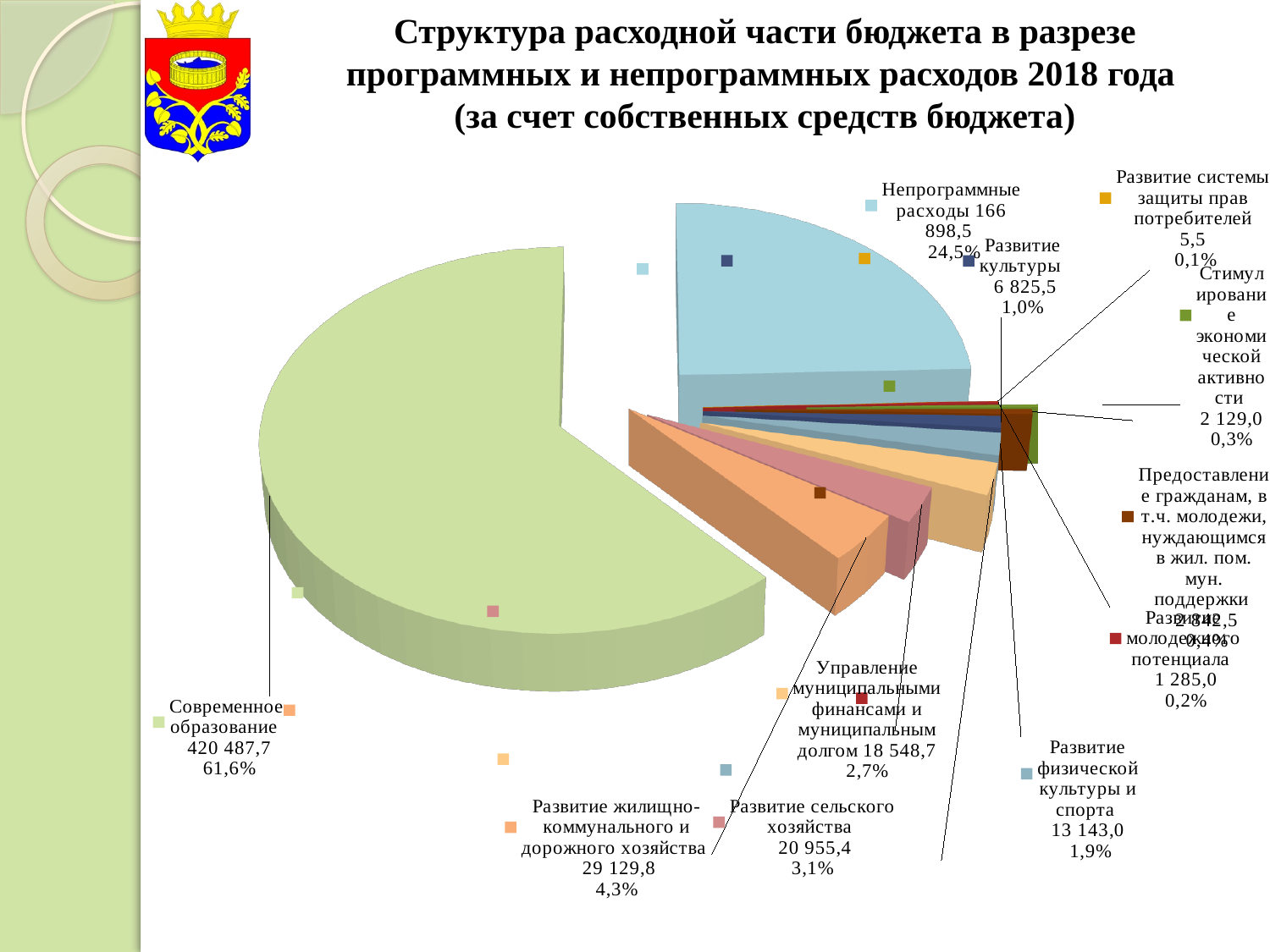
What is the value shown for Непрограммные расходы? 166 898,5 What is the value shown for Современное образование? 420 487,7 What is the value shown for Развитие физической культуры и спорта? 13 143,0 What type of chart is shown on the slide? pie chart Which category has the largest slice of the pie? Современное образование What percentage is shown for Развитие сельского хозяйства? 3,1% Which category has the smallest value in the chart? Развитие системы защиты прав потребителей What is the difference in percentage points between Современное образование (61,6%) and Непрограммные расходы (24,5%)? 37,1 What share of the pie does Современное образование take? 61,6% What year does the chart title refer to? 2018 How many categories are labelled in the pie chart? 11 Which is larger: Развитие жилищно-коммунального и дорожного хозяйства or Управление муниципальными финансами и муниципальным долгом? Развитие жилищно-коммунального и дорожного хозяйства